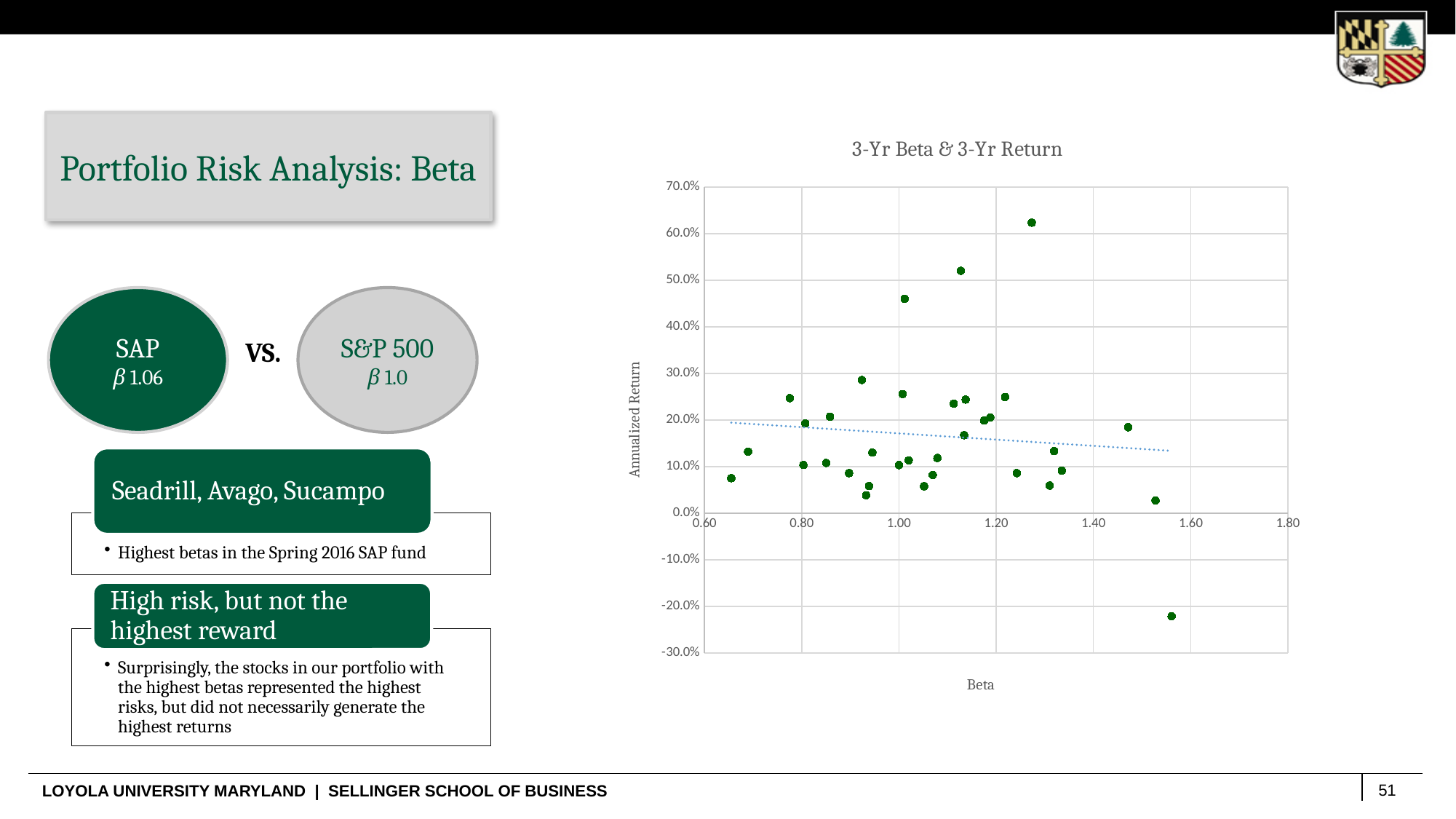
What kind of chart is shown on the slide? Scatter chart How many points in the chart have a negative annualized return? 1 Are there any points in the chart with a beta greater than 1.60? No Is the annualized return of the lowest point in the chart greater or less than -20.0%? less What is the label on the vertical axis of the chart? Annualized Return Is the beta of the point with the lowest annualized return greater or less than 1.40? greater Does the dotted trend line in the chart rise or fall as beta increases? Fall What is the title of the chart? 3-Yr Beta & 3-Yr Return How many points in the chart have an annualized return above 40.0%? 3